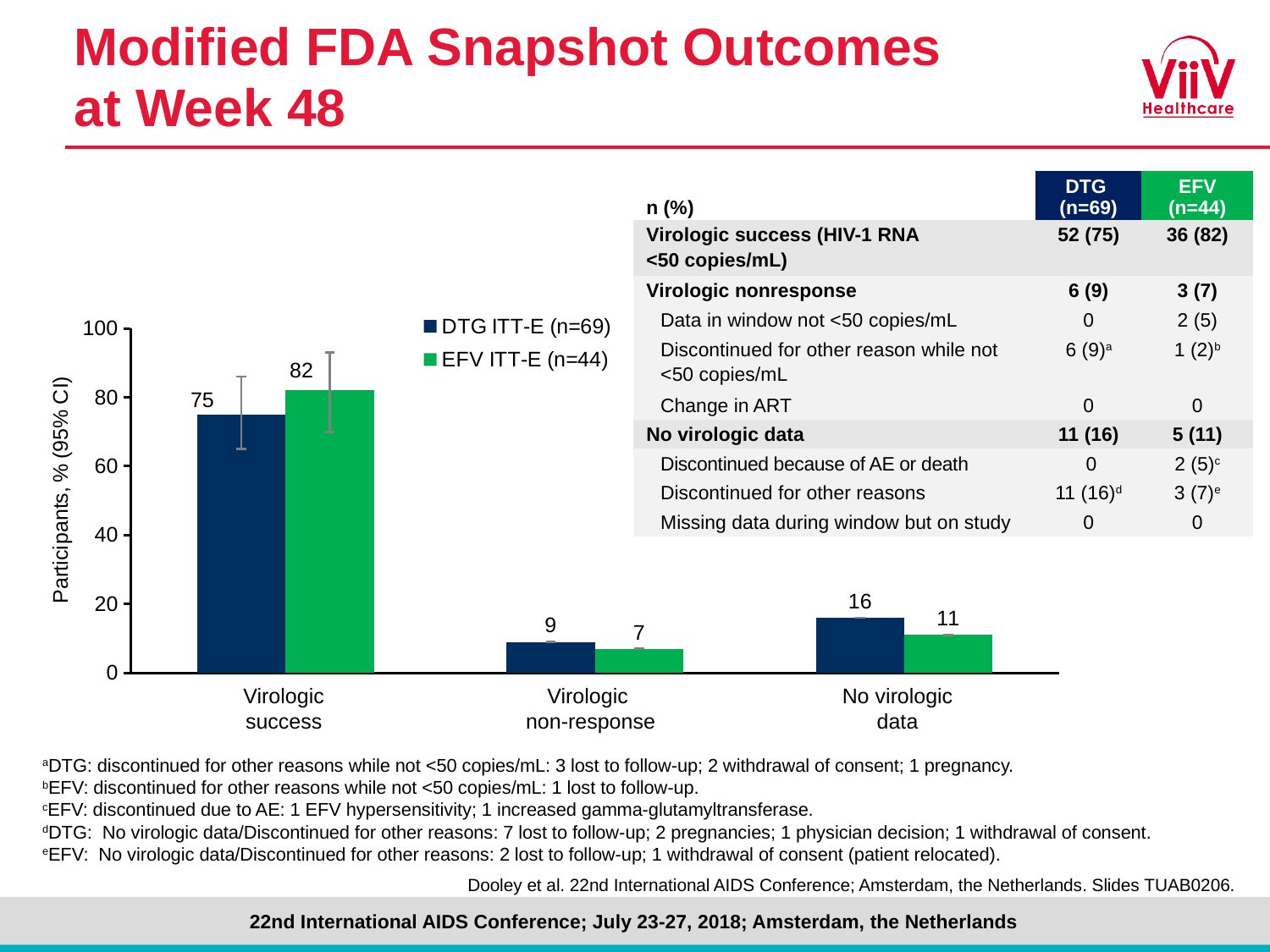
What kind of chart is shown on the slide? Bar chart How many categories are shown on the x axis of the chart? 3 What is the value for DTG ITT-E (n=69) in the Virologic success category? 75 What is the value for EFV ITT-E (n=44) in the No virologic data category? 11 What is the value for DTG ITT-E (n=69) in the Virologic non-response category? 9 What is the value for EFV ITT-E (n=44) in the Virologic success category? 82 What is the difference between the EFV ITT-E (n=44) and DTG ITT-E (n=69) values for Virologic success? 7 Which series has the larger value in the Virologic non-response category? DTG ITT-E (n=69) Which category has the lowest value for EFV ITT-E (n=44)? Virologic non-response What is the difference between the DTG ITT-E (n=69) and EFV ITT-E (n=44) values for No virologic data? 5 Which category has the highest value for DTG ITT-E (n=69)? Virologic success How many series does the chart legend list? 2